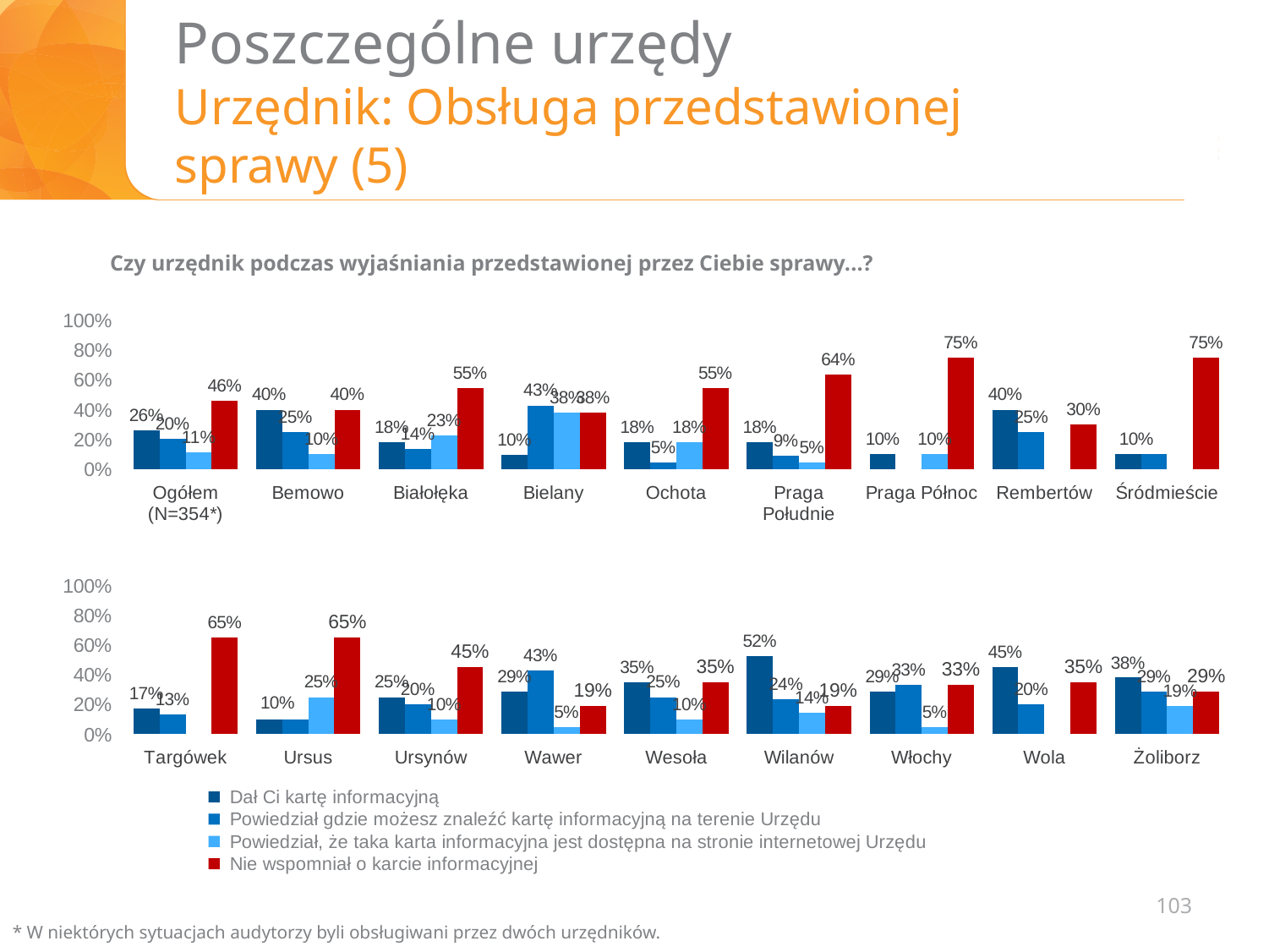
In the top chart, what is the value for 'Nie wspomniał o karcie informacyjnej' for Praga Południe? 64% In the top chart, is the 'Nie wspomniał o karcie informacyjnej' value for Rembertów greater or less than 40%? less In the bottom chart, which district has the lowest value for 'Nie wspomniał o karcie informacyjnej'? Wawer and Wilanów (19%) In the top chart, which district has the highest value for 'Nie wspomniał o karcie informacyjnej'? Praga Północ and Śródmieście (75%) In the bottom chart, which is larger for Targówek: 'Dał Ci kartę informacyjną' or 'Nie wspomniał o karcie informacyjnej'? Nie wspomniał o karcie informacyjnej In the bottom chart, what is the value for 'Powiedział gdzie możesz znaleźć kartę informacyjną na terenie Urzędu' for Wawer? 43% In the top chart, what is the difference between the 'Nie wspomniał o karcie informacyjnej' values for Białołęka and Bemowo? 15 percentage points In the bottom chart, what is the value for 'Dał Ci kartę informacyjną' for Wilanów? 52% What type of chart is used on this slide? Bar chart In the top chart, what is the value for 'Dał Ci kartę informacyjną' for Ogółem (N=354*)? 26% How many districts/categories are shown in the bottom chart? 9 How many series does the legend list? 4